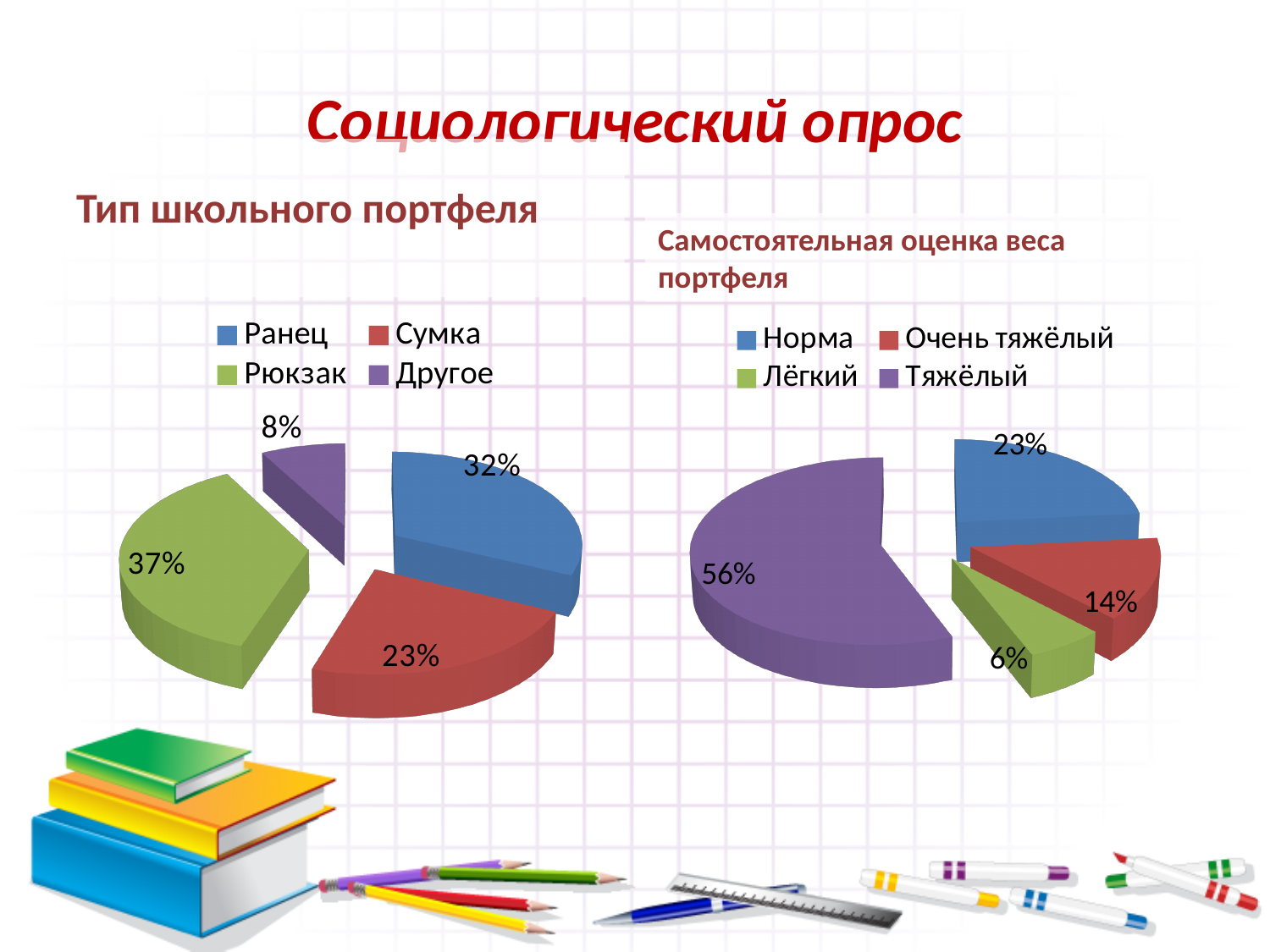
In the chart "Тип школьного портфеля", which category has the largest slice? Рюкзак In the chart "Самостоятельная оценка веса портфеля", which is larger, Норма or Очень тяжёлый? Норма In the chart "Самостоятельная оценка веса портфеля", what share is labelled for Лёгкий? 6% In the chart "Тип школьного портфеля", how many categories does the legend list? 4 In the chart "Самостоятельная оценка веса портфеля", which category has the largest slice? Тяжёлый What kind of chart is used for "Самостоятельная оценка веса портфеля"? Pie chart In the chart "Тип школьного портфеля", what share is labelled for Рюкзак? 37% In the chart "Самостоятельная оценка веса портфеля", what share is labelled for Тяжёлый? 56% In the chart "Самостоятельная оценка веса портфеля", what colour is the slice for Тяжёлый? Purple In the chart "Тип школьного портфеля", what share is labelled for Другое? 8% In the chart "Тип школьного портфеля", what is the difference in percentage points between Ранец and Сумка? 9 In the chart "Тип школьного портфеля", which category has the smallest slice? Другое